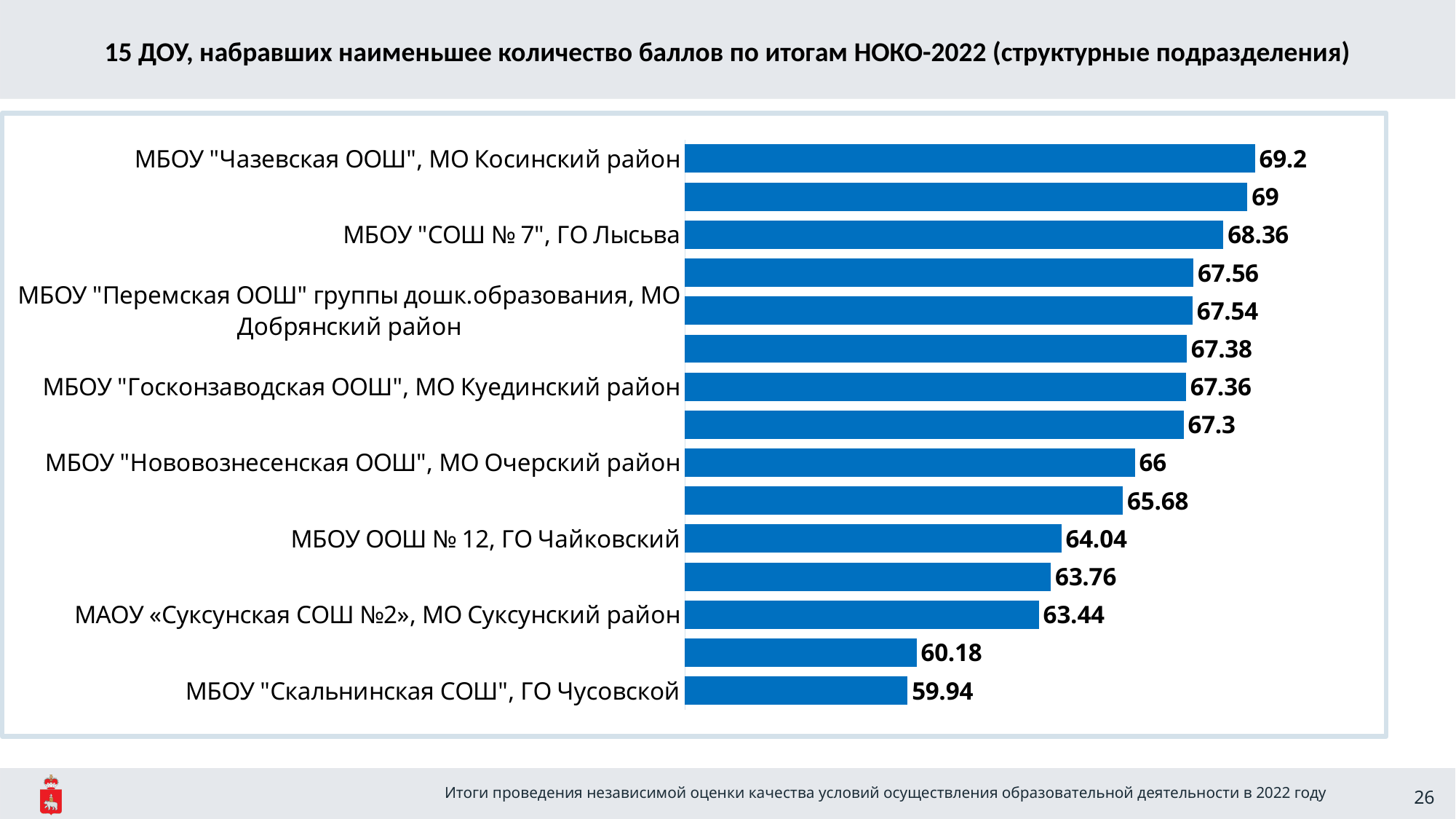
What is the value for МБОУ "Скальнинская СОШ", ГО Чусовской? 59.94 Which institution has the highest value in the chart? МБОУ "Чазевская ООШ", МО Косинский район What type of chart is shown on the slide? bar chart How many bars are plotted in the chart? 15 What is the value for МБОУ "Нововознесенская ООШ", МО Очерский район? 66 Which institution has the lowest value in the chart? МБОУ "Скальнинская СОШ", ГО Чусовской What is the value for МБОУ ООШ № 12, ГО Чайковский? 64.04 What is the value for МБОУ "Госконзаводская ООШ", МО Куединский район? 67.36 What is the value for МБОУ "Чазевская ООШ", МО Косинский район? 69.2 What is the value for МБОУ "СОШ № 7", ГО Лысьва? 68.36 Which has a larger value: МАОУ «Суксунская СОШ №2», МО Суксунский район or МБОУ ООШ № 12, ГО Чайковский? МБОУ ООШ № 12, ГО Чайковский What is the difference between the values for МБОУ "Чазевская ООШ", МО Косинский район and МБОУ "Скальнинская СОШ", ГО Чусовской? 9.26